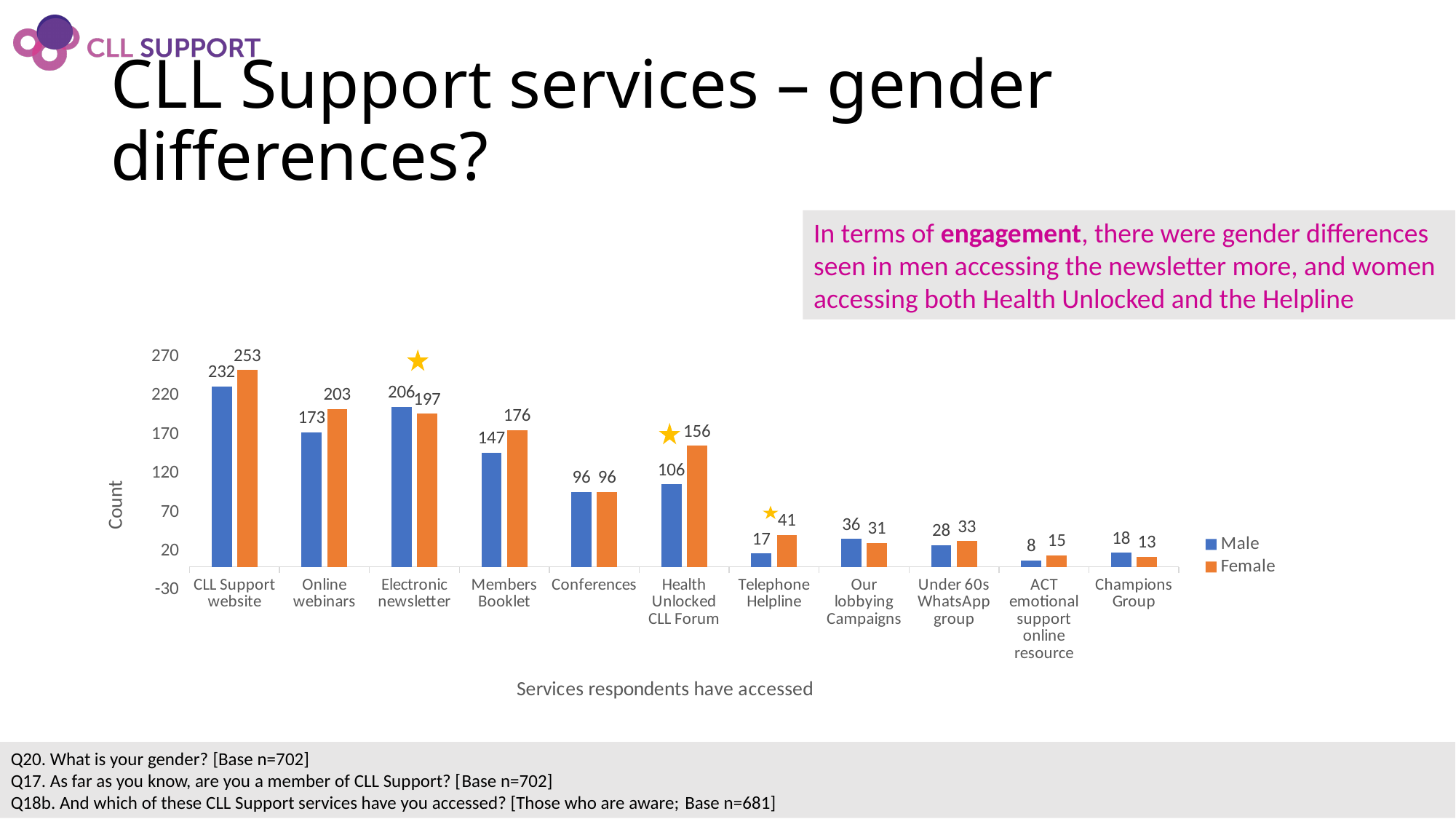
What is the Female count for Health Unlocked CLL Forum? 156 Which is larger for Our lobbying Campaigns, the Male count or the Female count? Male What kind of chart is shown on the slide? Bar chart What is the difference between the Female and Male counts for Health Unlocked CLL Forum? 50 Which service has the highest Female count? CLL Support website Which service has the lowest Male count? ACT emotional support online resource What is the label of the x axis? Services respondents have accessed What is the Male count for the Electronic newsletter? 206 How many services are shown on the x axis? 11 How many series does the legend list? 2 What is the Female count for the Telephone Helpline? 41 What is the difference between the Male and Female counts for the Electronic newsletter? 9